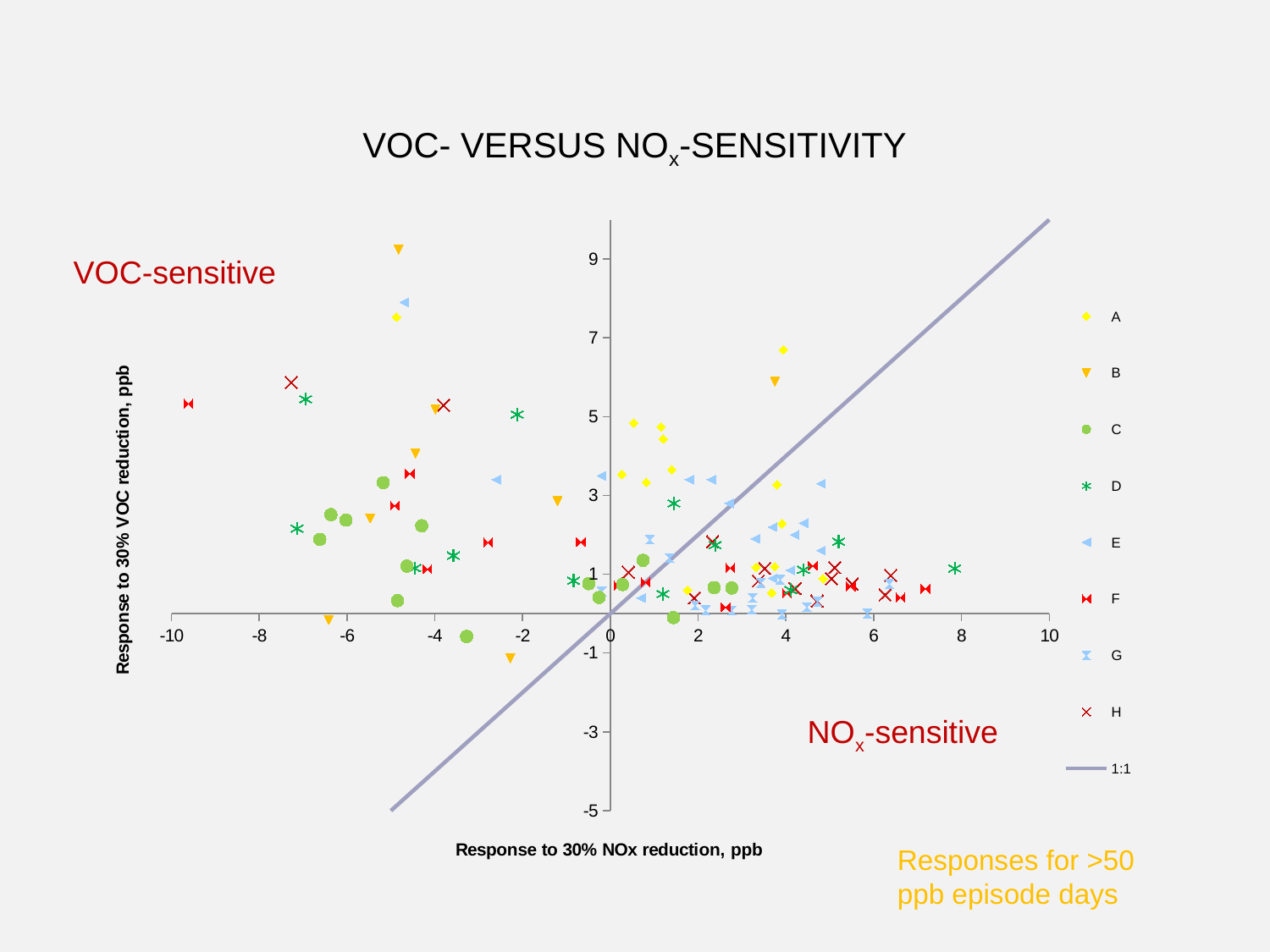
Is the highest point of series H greater or less than 5 on the y axis? greater Which series has the single highest point on the chart? B What is the label of the x axis? Response to 30% NOx reduction, ppb What kind of chart is shown on the slide? scatter chart How many entries does the chart legend list? 9 What is the maximum value shown on the x axis? 10 What is the minimum value shown on the y axis? -5 Is the x value of the leftmost point of series F greater or less than -8? less Is the highest point of series B greater or less than 9 on the y axis? greater How many lettered data series (A through H) does the legend list? 8